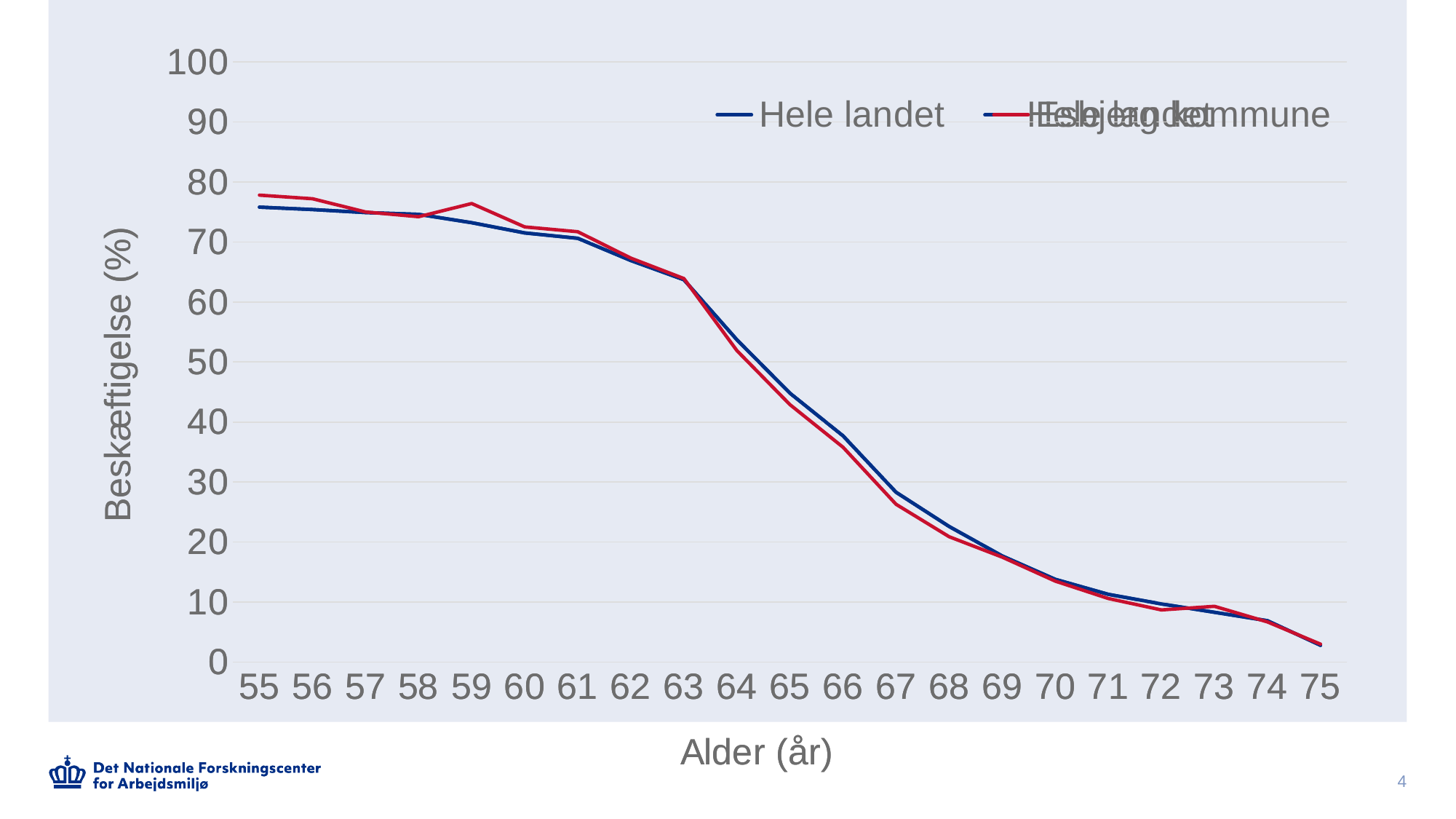
At age 55, which line is higher: the blue Hele landet line or the red line? the red line Is the value for Hele landet at age 75 greater or less than 10? less At age 65, which line is higher: the blue Hele landet line or the red line? Hele landet How many age points are plotted along the x axis? 21 How many series does the legend list? 2 Do the values for Hele landet rise or fall as age increases along the x axis? fall What kind of chart is shown on the slide? line chart What is the label of the y axis? Beskæftigelse (%) Is the value of the red line at age 59 greater or less than 70? greater Is the value for Hele landet at age 67 greater or less than 30? less